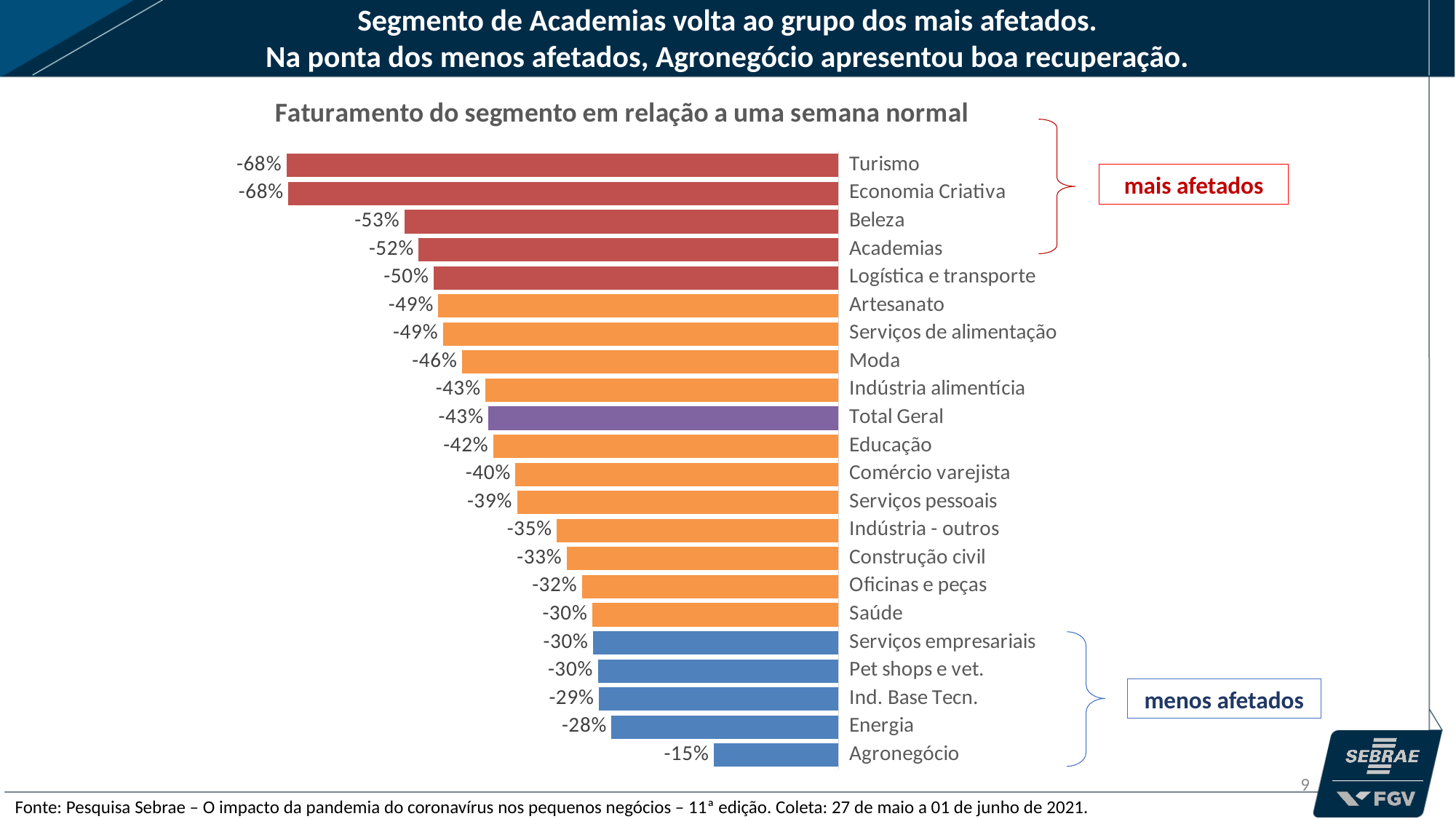
What is the difference in percentage points between the values for Turismo (-68%) and Agronegócio (-15%)? 53 percentage points What type of chart is shown on the slide? Bar chart What is the value shown for Total Geral? -43% What is the value shown for Academias? -52% What is the difference in percentage points between the values for Beleza and Academias? 1 percentage point Which label is shown in the red box next to the top bars of the chart? mais afetados Which segment shows the smallest decline (the value closest to zero)? Agronegócio What is the title of the chart? Faturamento do segmento em relação a uma semana normal How many bars (segments, including Total Geral) are shown in the chart? 22 What is the value shown for Beleza? -53% Which segment has a larger decline, Moda or Educação? Moda What is the value shown for Agronegócio? -15%